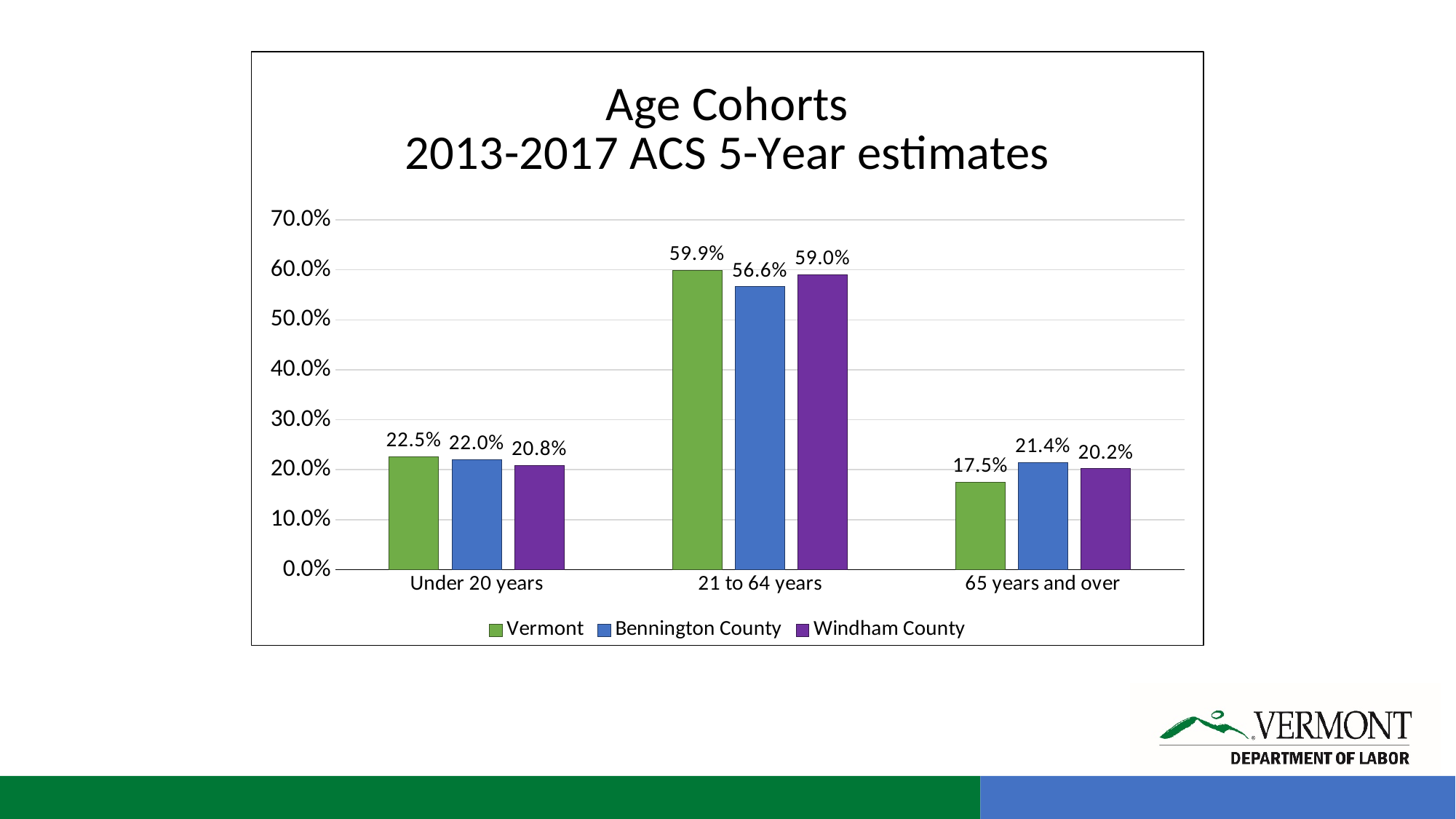
What is the value for Windham County in the Under 20 years cohort? 20.8% How many series does the legend list? 3 Which series is shown in purple in the legend? Windham County What is the value for Vermont in the 21 to 64 years cohort? 59.9% What is the difference between the Vermont and Bennington County values in the 21 to 64 years cohort? 3.3% What kind of chart is shown on the slide? Bar chart How many age cohorts are shown on the x axis? 3 Which age cohort has the highest value for Bennington County? 21 to 64 years What is the value for Bennington County in the 65 years and over cohort? 21.4% Which age cohort has the lowest value for Vermont? 65 years and over Which is larger in the 65 years and over cohort: Vermont or Windham County? Windham County Is the value for Bennington County in the 21 to 64 years cohort greater or less than 50.0%? greater